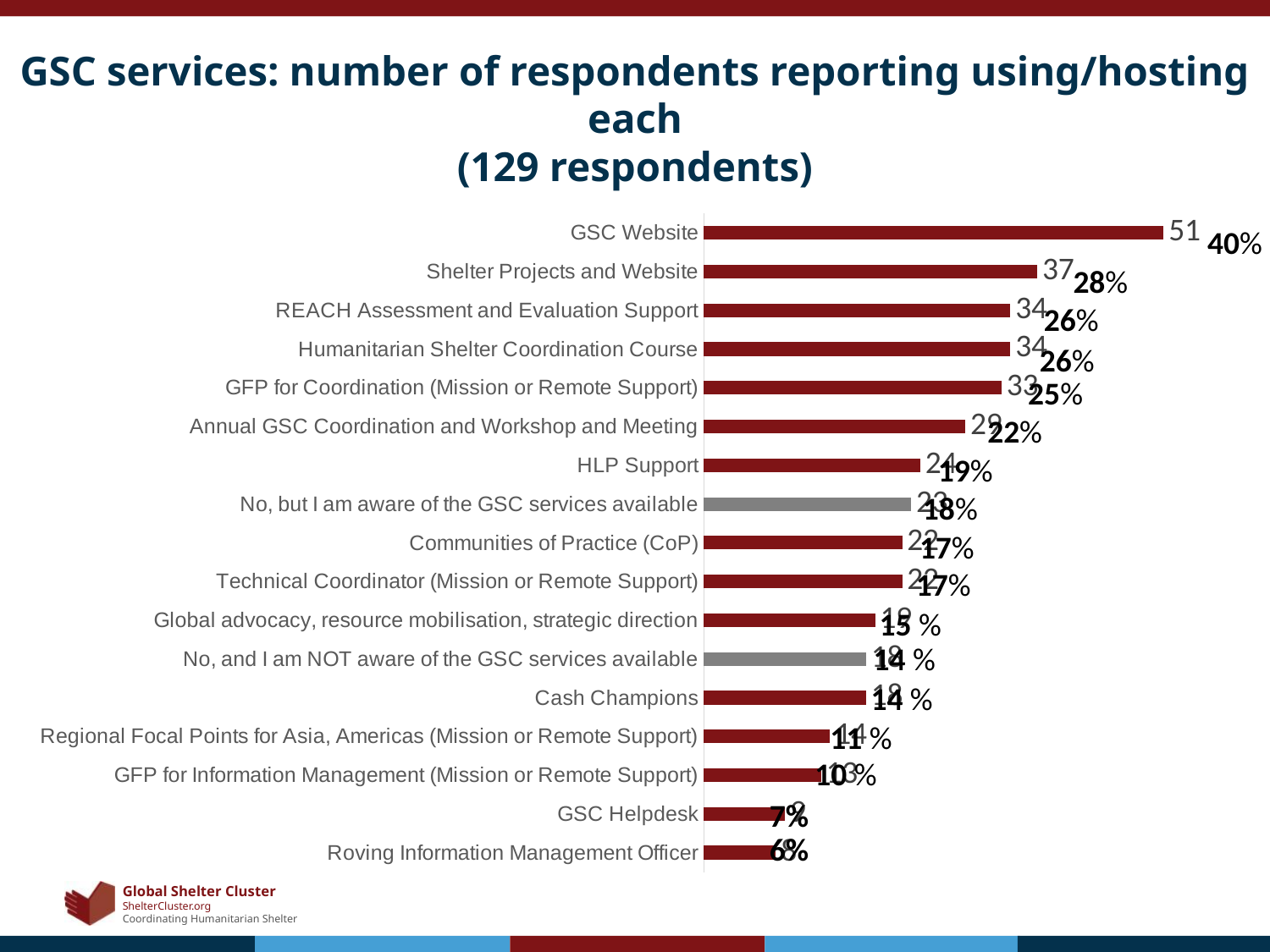
What percentage is shown for GFP for Coordination (Mission or Remote Support)? 25% Which GSC service has the highest number of respondents? GSC Website Which category has the lowest value on the chart? Roving Information Management Officer What percentage is shown for HLP Support? 19% How many respondents reported using Shelter Projects and Website? 37 What percentage of respondents reported using the GSC Website? 40% How many respondents does the chart title say took part? 129 What type of chart is shown on the slide? Bar chart What is the difference in number of respondents between the GSC Website and Shelter Projects and Website? 14 How many respondents reported using the GSC Website? 51 How many categories are shown on the chart? 17 Which has more respondents: GFP for Coordination (Mission or Remote Support) or HLP Support? GFP for Coordination (Mission or Remote Support)